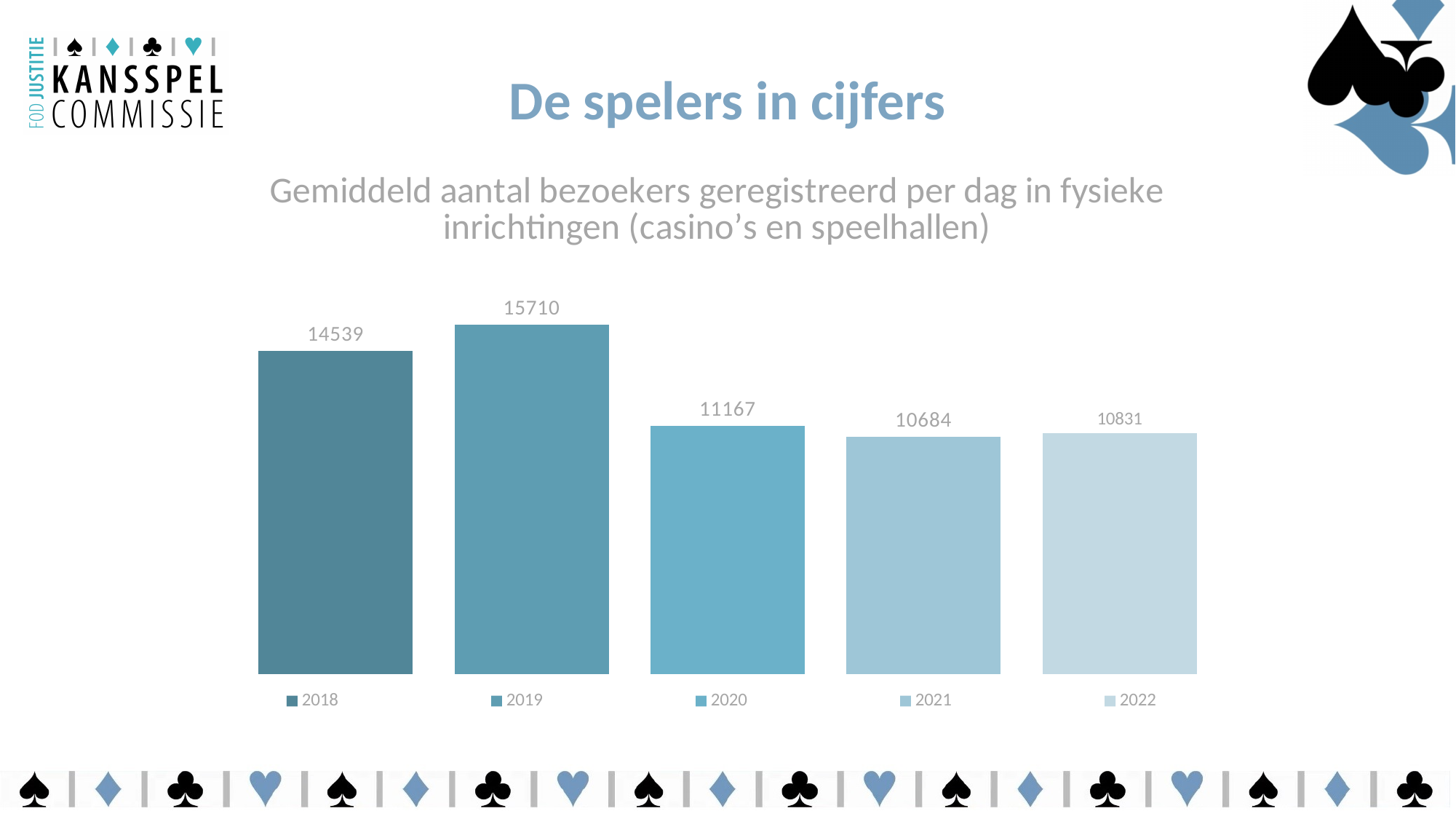
How many entries does the legend list? 5 What is the title of the chart? Gemiddeld aantal bezoekers geregistreerd per dag in fysieke inrichtingen (casino’s en speelhallen) What is the value for 2019? 15710 Which is larger, the value for 2018 or the value for 2020? 2018 How many years are shown in the chart? 5 Which year has the lowest value? 2021 What is the value for 2018? 14539 What is the difference between the values for 2020 and 2022? 336 Which year has the highest value? 2019 What is the difference between the values for 2019 and 2018? 1171 What kind of chart is shown on the slide? bar chart What is the value for 2021? 10684